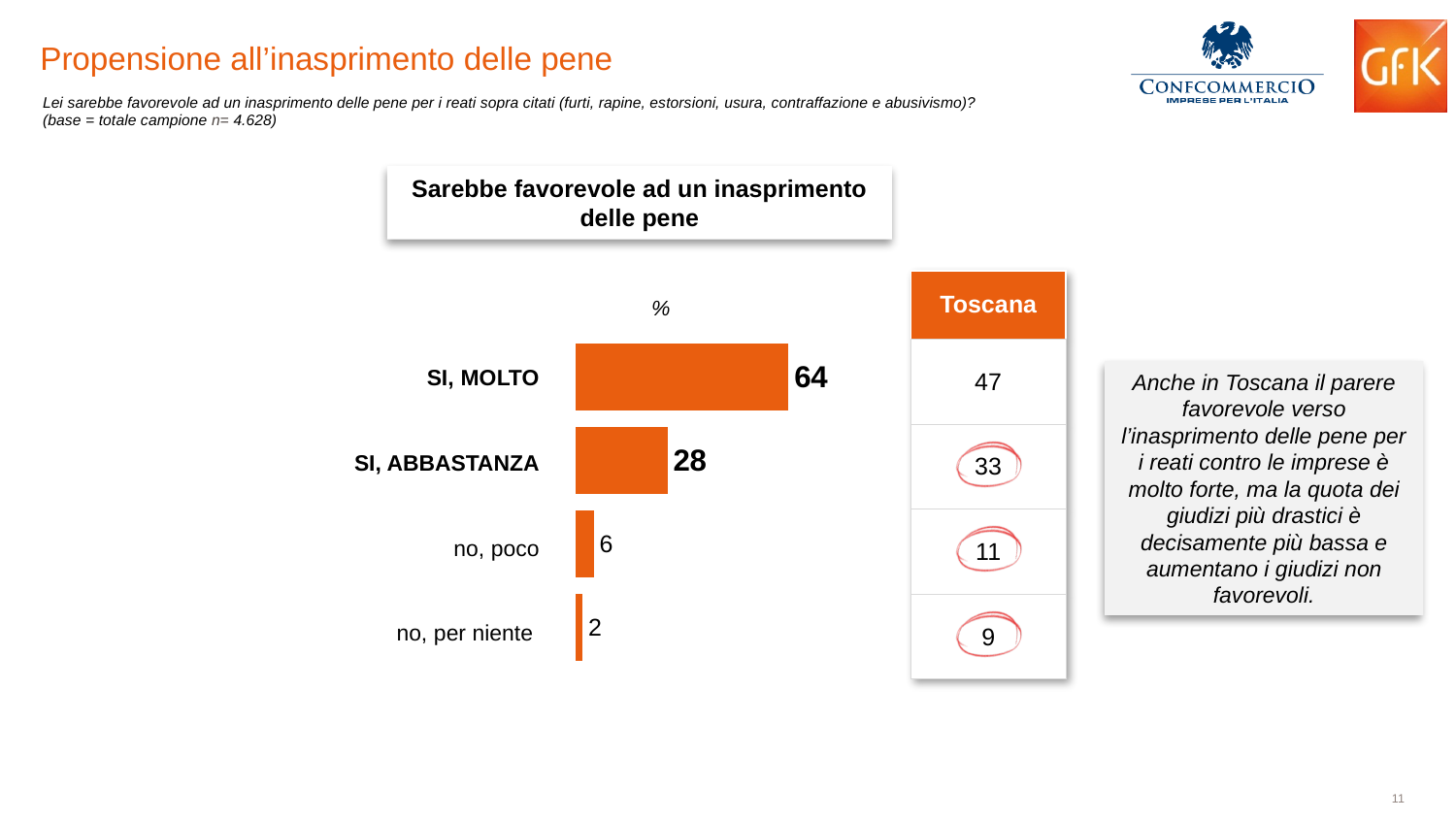
How many categories are shown in the bar chart? 4 What is the value for "no, poco" in the bar chart? 6 What kind of chart is shown on the slide? bar chart Which category has the lowest value in the bar chart? no, per niente What is the difference between the values for "SI, MOLTO" and "SI, ABBASTANZA" in the bar chart? 36 Which is larger in the bar chart, "no, poco" or "no, per niente"? no, poco What is the title shown above the bar chart? Sarebbe favorevole ad un inasprimento delle pene What is the value for "SI, ABBASTANZA" in the bar chart? 28 Which category has the highest value in the bar chart? SI, MOLTO What is the value for "no, per niente" in the bar chart? 2 What is the value for "SI, MOLTO" in the bar chart? 64 What is the Toscana value shown next to "SI, MOLTO"? 47